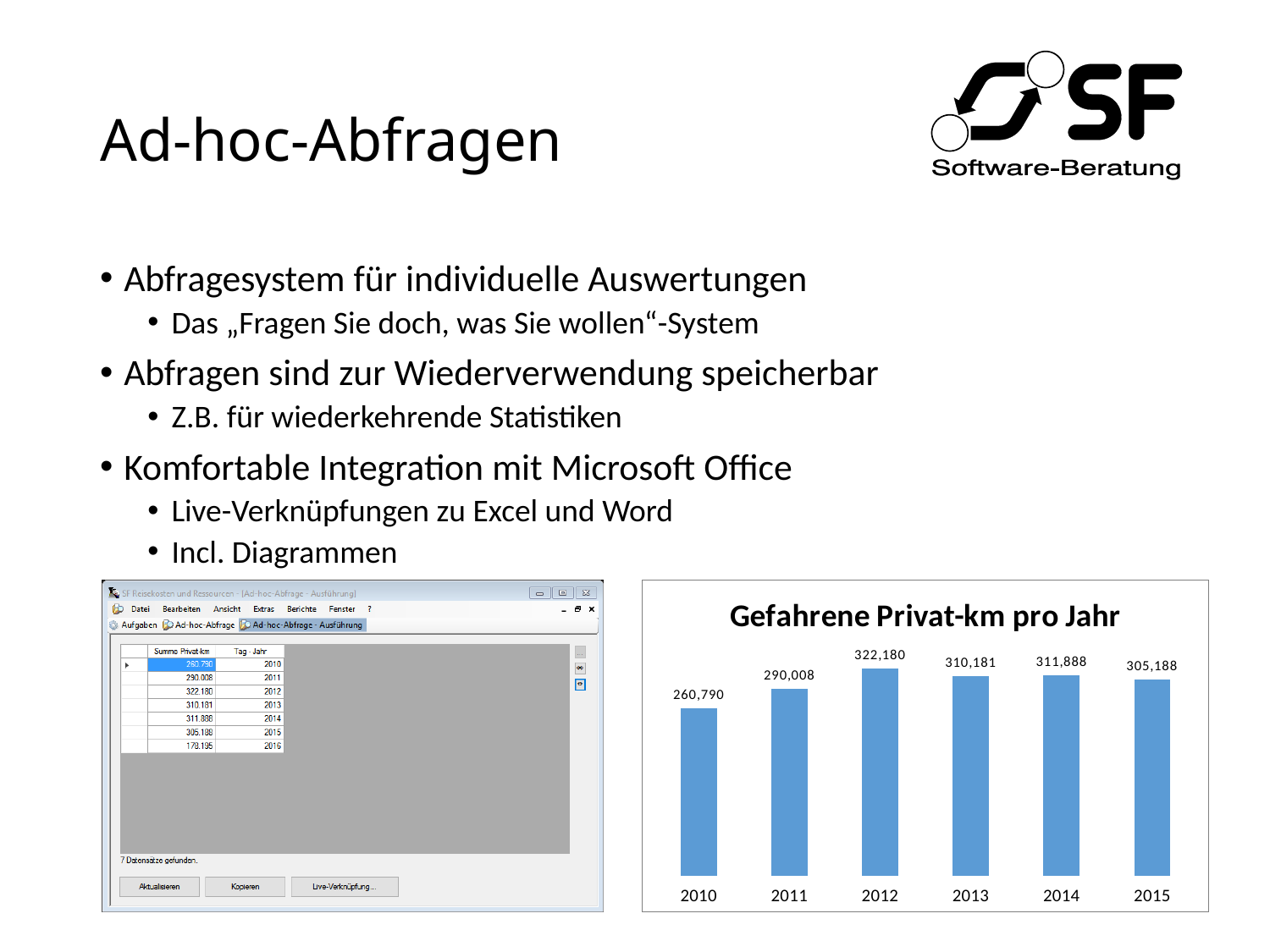
What is the title of the chart? Gefahrene Privat-km pro Jahr Which is larger, the value for 2011 or the value for 2013? 2013 Do the values rise or fall from 2010 to 2012? rise What is the difference between the values for 2012 and 2010? 61,390 What kind of chart is shown on the slide? bar chart Which year has the lowest value in the chart? 2010 What is the value for 2012 in the chart? 322,180 What is the value for 2015 in the chart? 305,188 Which year has the highest value in the chart? 2012 What is the difference between the values for 2011 and 2010? 29,218 What is the value for 2010 in the chart? 260,790 How many years are shown in the chart? 6